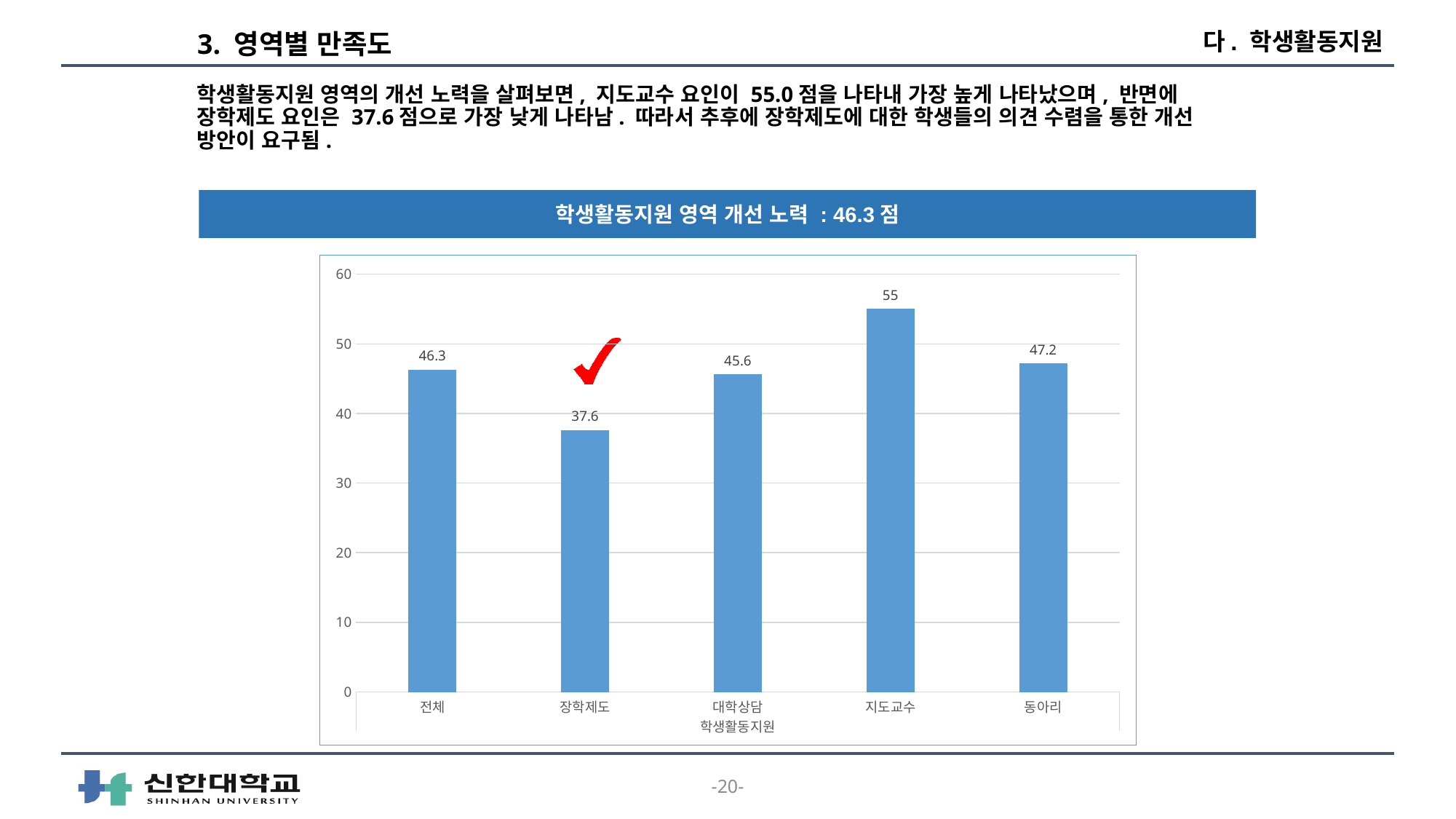
What is the value for 전체? 46.3 How many categories are shown on the x axis? 5 What is the x-axis group label shown below the category names? 학생활동지원 What kind of chart is shown on the slide? Bar chart Which is larger, the value for 동아리 or the value for 대학상담? 동아리 What is the value for 장학제도? 37.6 What is the value for 동아리? 47.2 Which category has the highest value? 지도교수 What is the difference between the values for 지도교수 and 장학제도? 17.4 What is the value for 지도교수? 55 Which category has the lowest value? 장학제도 What is the value for 대학상담? 45.6